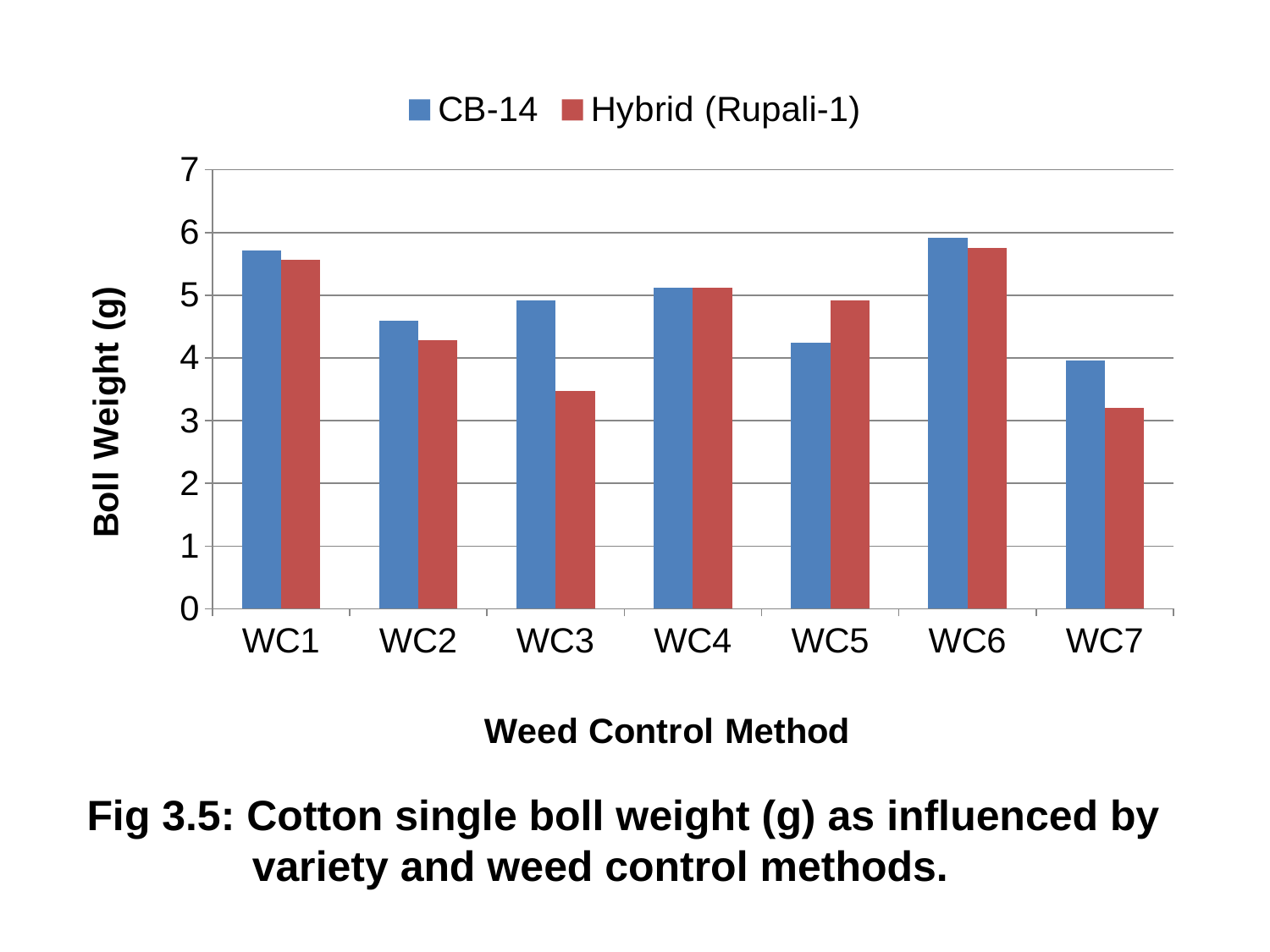
What kind of chart is shown on the slide? bar chart Is the boll weight for CB-14 at WC1 greater or less than 5? greater What is the label of the y axis? Boll Weight (g) At WC5, which variety has the larger boll weight, CB-14 or Hybrid (Rupali-1)? Hybrid (Rupali-1) How many series does the legend list? 2 Is the boll weight for Hybrid (Rupali-1) at WC3 greater or less than 4? less Which weed control method has the highest boll weight for CB-14? WC6 Is the boll weight for CB-14 at WC6 greater or less than 6? less Which weed control method has the lowest boll weight for Hybrid (Rupali-1)? WC7 Which weed control method has the lowest boll weight for CB-14? WC7 How many weed control methods are shown on the x axis? 7 At WC3, which variety has the larger boll weight, CB-14 or Hybrid (Rupali-1)? CB-14